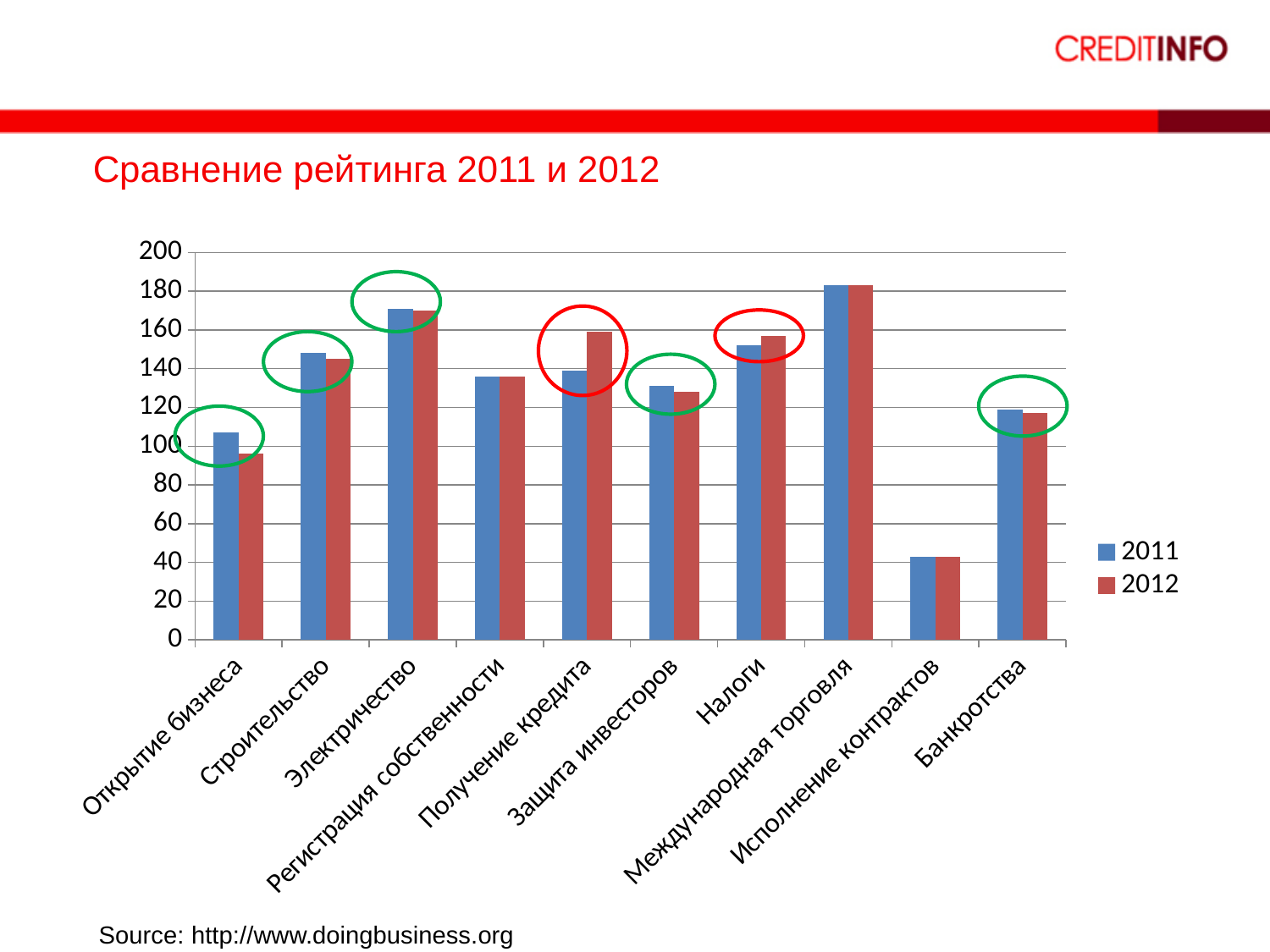
Which category has the highest value for 2012? Международная торговля Is the 2012 value for Получение кредита greater or less than 140? greater For Получение кредита, which is larger: the 2011 value or the 2012 value? 2012 Is the 2011 value for Защита инвесторов greater or less than 120? greater For Открытие бизнеса, which is larger: the 2011 value or the 2012 value? 2011 Which category has the lowest value for 2011? Исполнение контрактов Is the 2011 value for Исполнение контрактов greater or less than 60? less What is the title of the chart on the slide? Сравнение рейтинга 2011 и 2012 How many categories are shown on the x axis of the chart? 10 How many series does the legend list? 2 What kind of chart is shown on the slide? bar chart